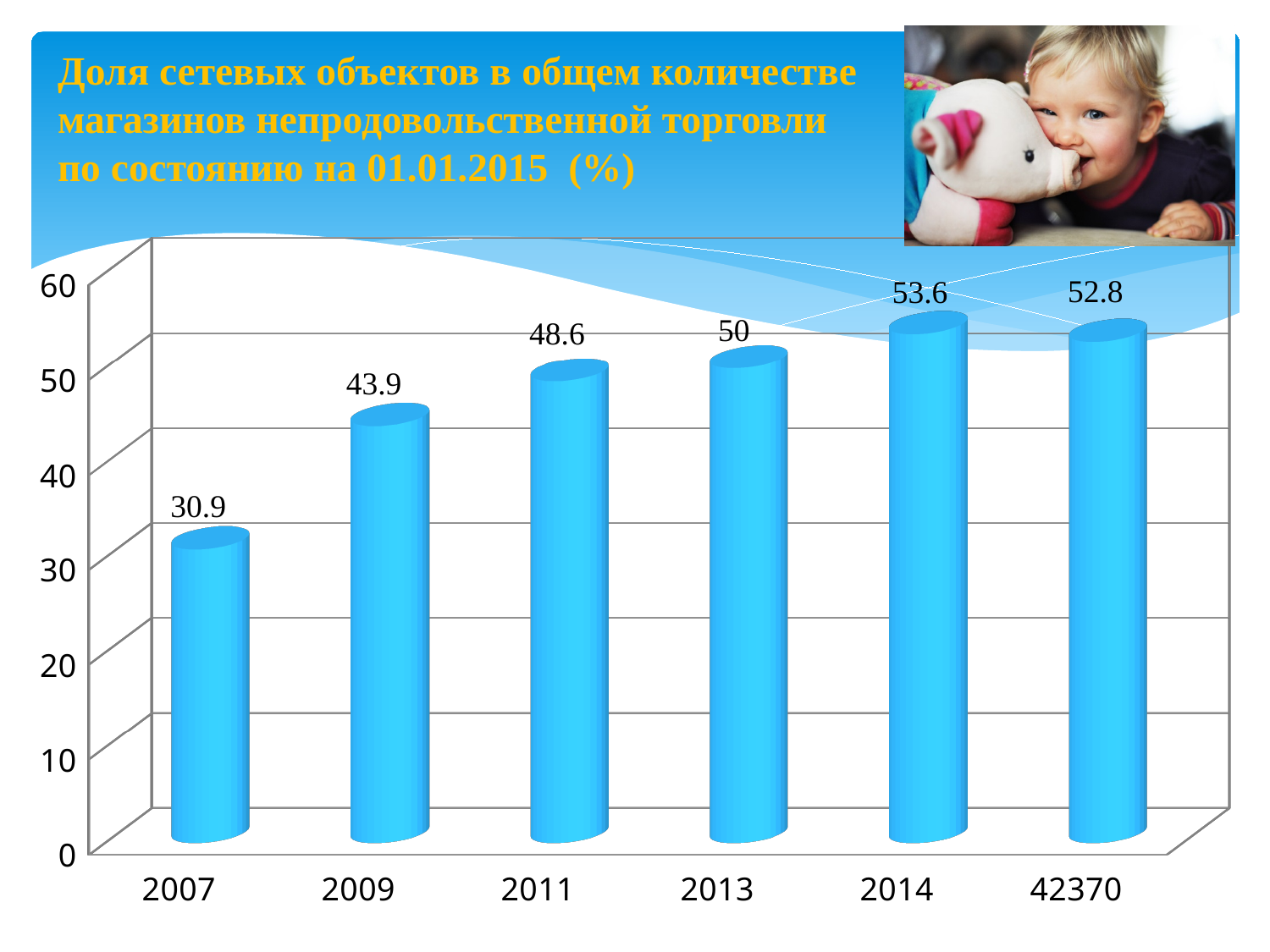
Is the value for 2009 greater or less than 40? greater Which is larger, the value for 2013 or the value for 2009? 2013 Which category has the lowest value? 2007 What is the difference between the values for 2014 and 2007? 22.7 What is the value for 2011? 48.6 What is the value for the last category, labelled 42370? 52.8 What is the value for 2014? 53.6 Which category has the highest value? 2014 What kind of chart is shown on the slide? bar chart Do the values generally rise or fall from 2007 to 2014? rise How many categories are shown on the x axis? 6 What is the value for 2007? 30.9